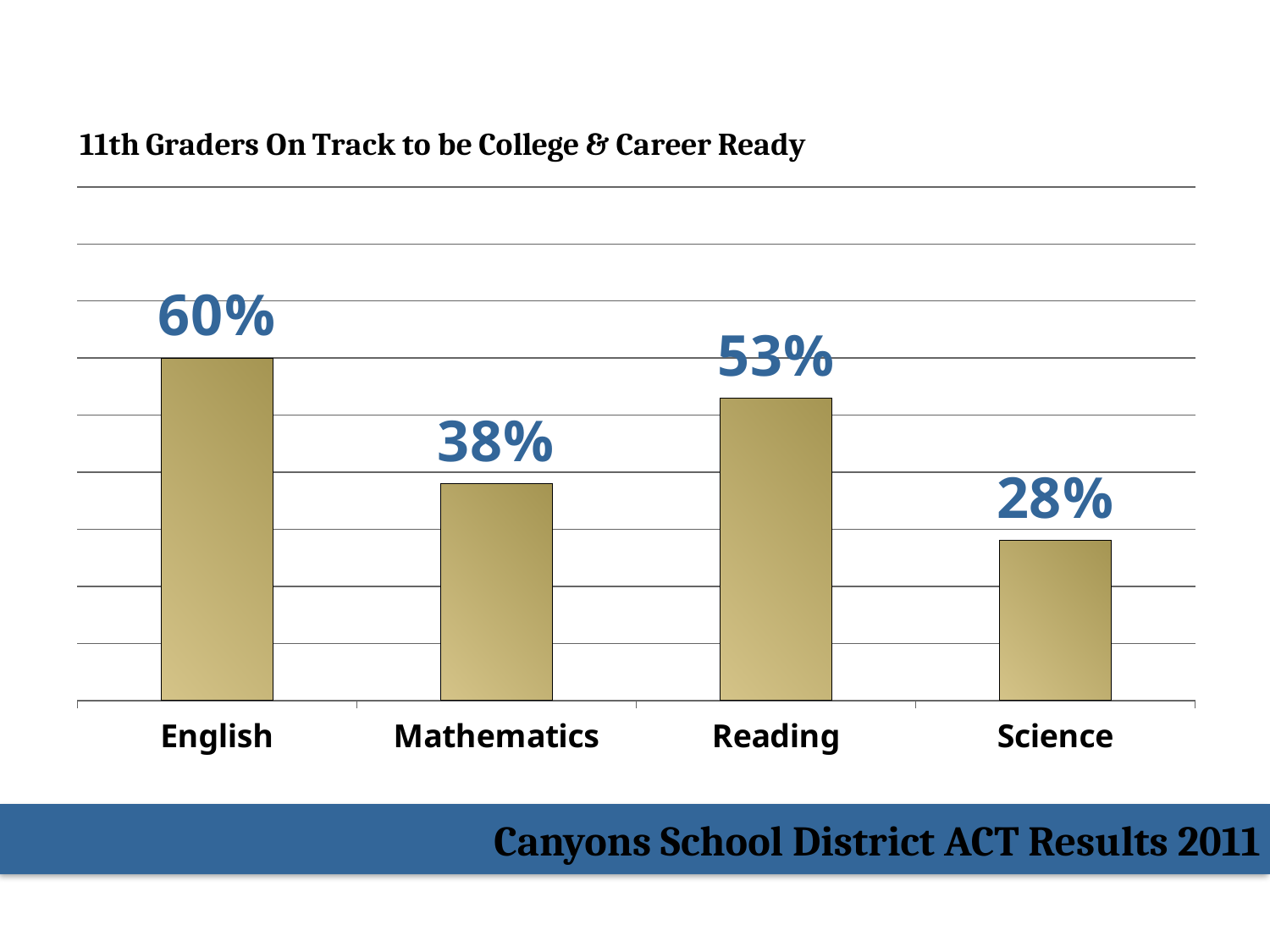
Which subject has the highest percentage of 11th graders on track? English What is the title of the chart? 11th Graders On Track to be College & Career Ready Which is larger, the value for Reading or the value for Mathematics? Reading What is the difference between the Reading and Mathematics percentages? 15% What kind of chart is shown on the slide? Bar chart What is the value shown for Mathematics? 38% How many subjects are shown on the chart? 4 Which subject has the lowest percentage of 11th graders on track? Science What is the value shown for Science? 28% What is the difference between the English and Science percentages? 32% What percentage of 11th graders are on track to be college and career ready in English? 60% What is the value shown for Reading? 53%